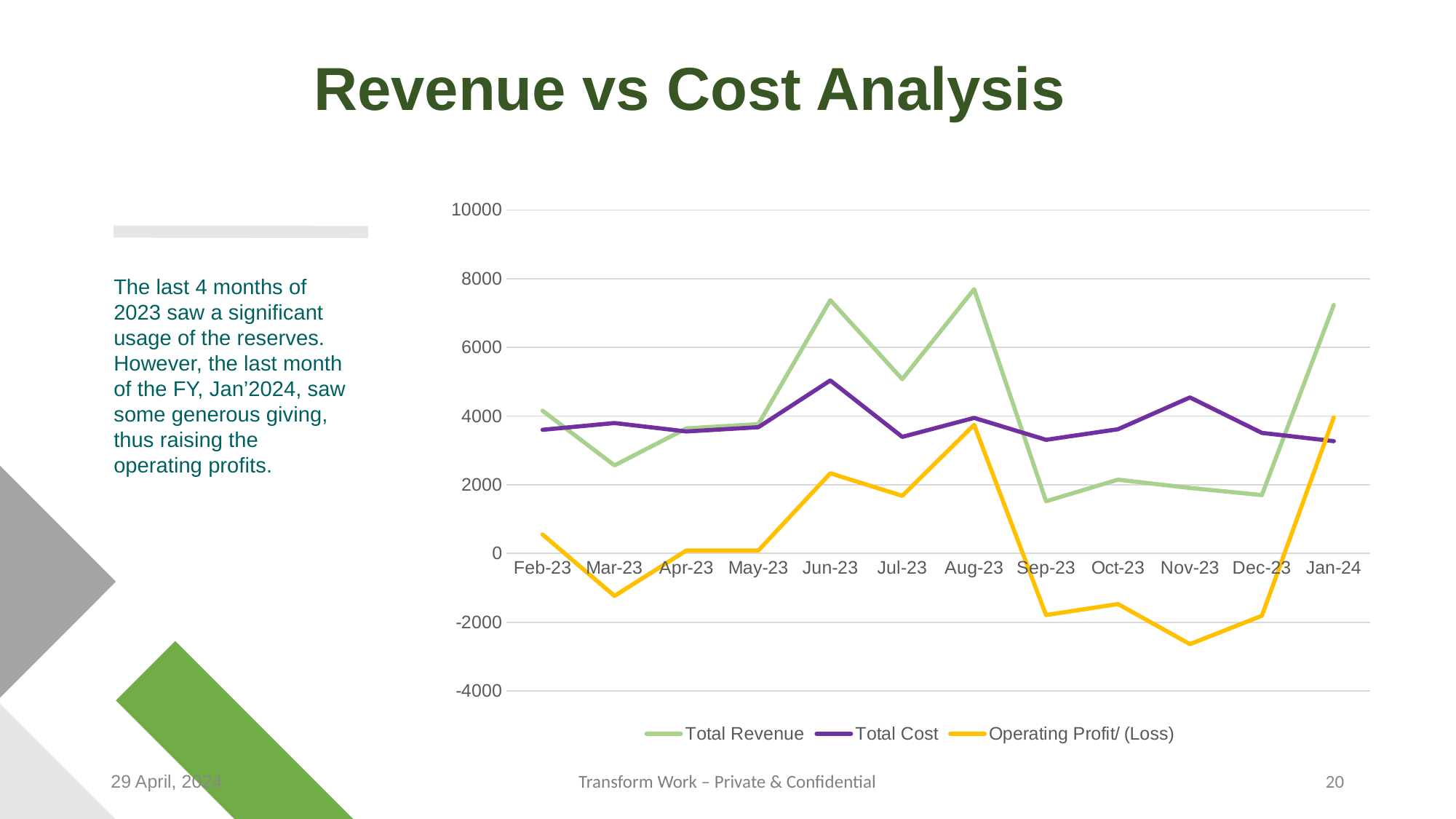
Is the Operating Profit/ (Loss) value for Nov-23 greater or less than -2000? less In which month does Total Revenue reach its highest value? Aug-23 Does Operating Profit/ (Loss) rise or fall from Aug-23 to Nov-23? Fall How many months are plotted along the x axis? 12 Is the Total Revenue value for Jun-23 greater or less than 6000? greater In which month does Total Cost reach its highest value? Jun-23 In which month is Operating Profit/ (Loss) at its lowest? Nov-23 What kind of chart is shown on the slide? Line chart Is the Total Revenue value for Sep-23 greater or less than 2000? less In Sep-23, which is larger: Total Revenue or Total Cost? Total Cost How many series does the legend list? 3 Which series is drawn in yellow? Operating Profit/ (Loss)